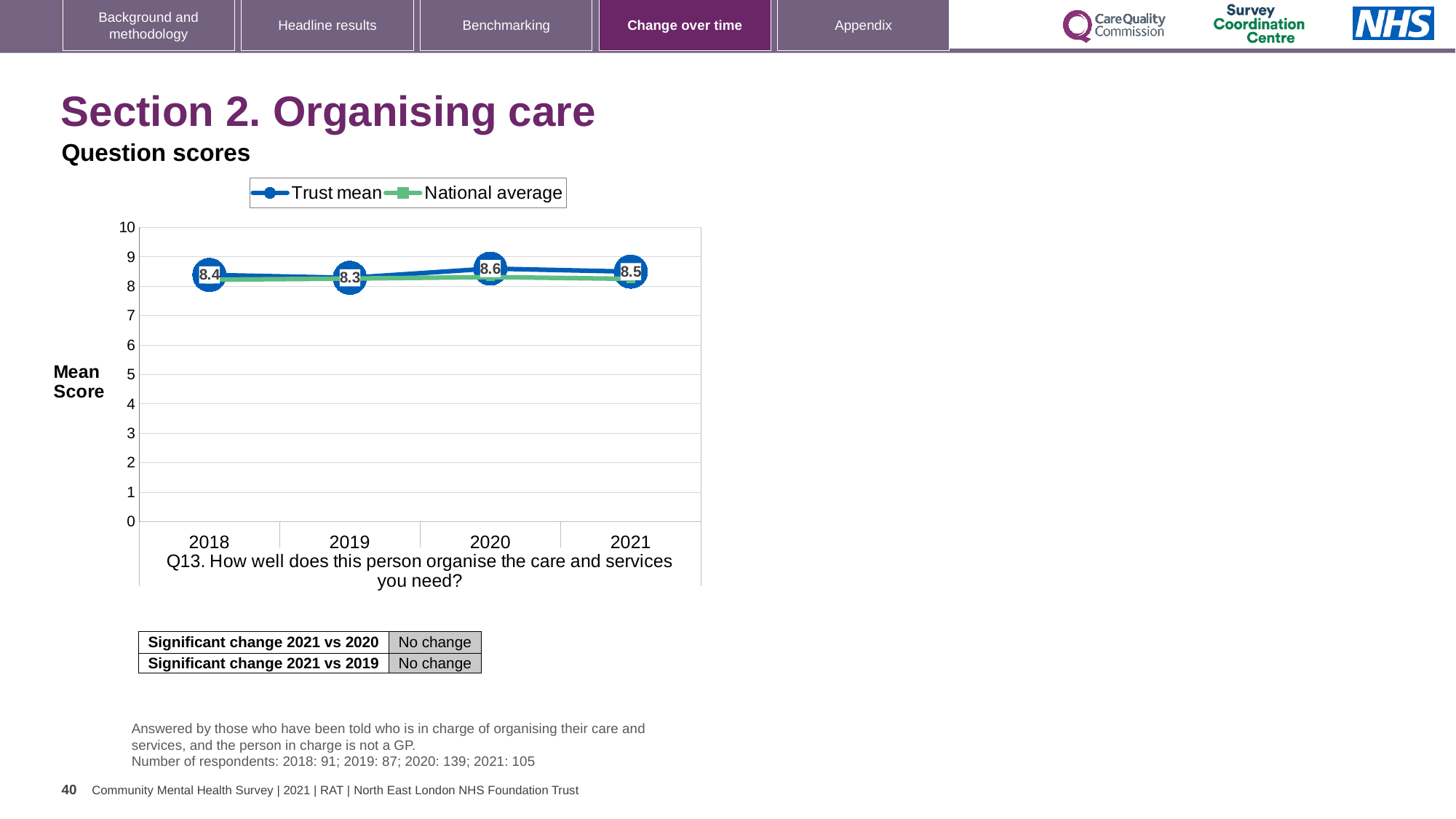
What is the Trust mean score for 2020? 8.6 How many years are shown on the x axis of the chart? 4 Is the National average value for 2018 greater or less than 5? greater What is the difference between the Trust mean scores for 2020 and 2019? 0.3 How many series does the chart legend list? 2 Which year has the larger Trust mean score, 2018 or 2021? 2021 What kind of chart is shown on the slide? Line chart What are the two series named in the chart legend? Trust mean and National average In which year is the Trust mean score highest? 2020 Did the Trust mean score rise or fall from 2019 to 2020? Rise What is the Trust mean score for 2018? 8.4 In which year is the Trust mean score lowest? 2019